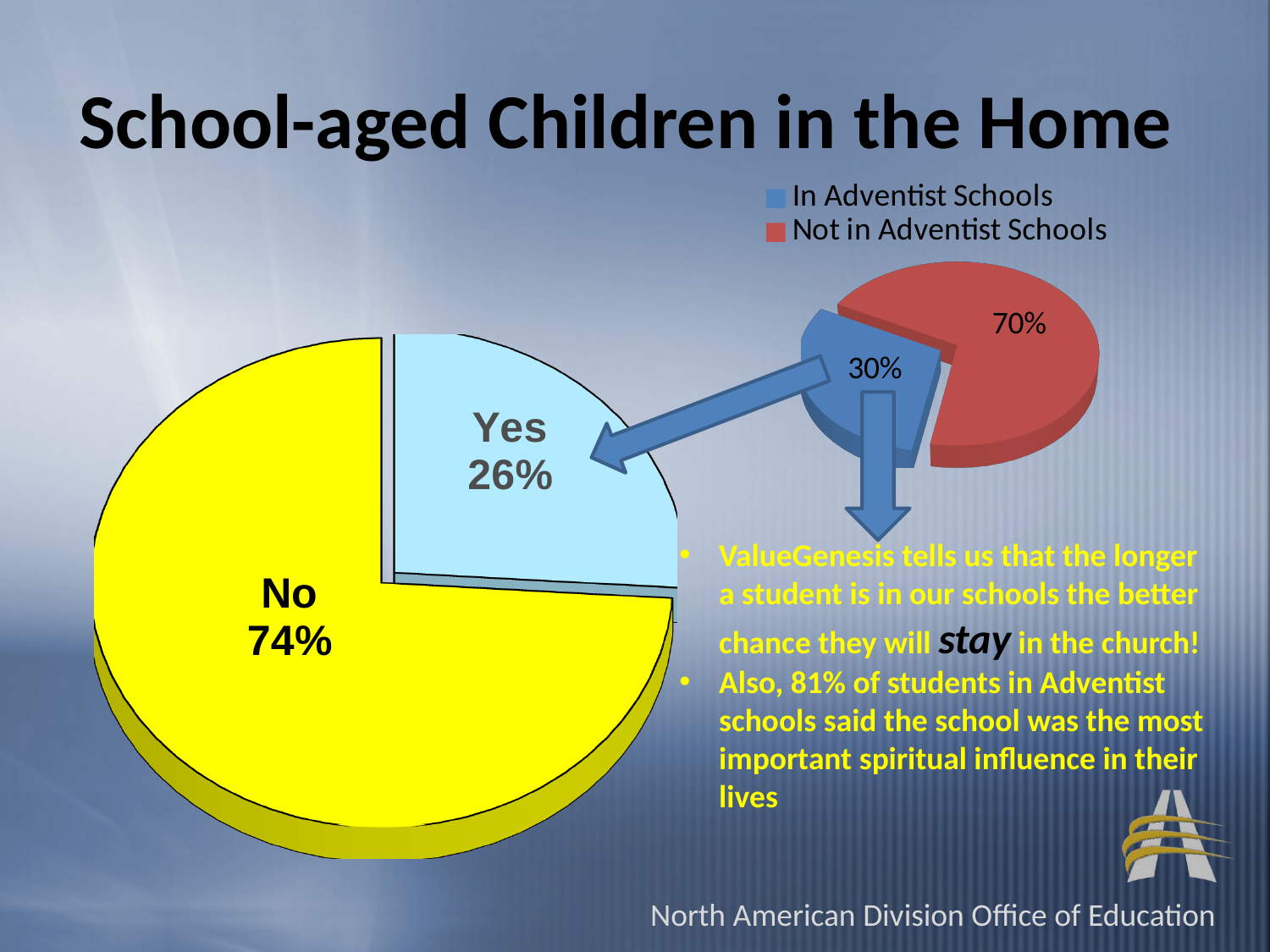
In the large pie chart on the left, what percentage is labelled "No"? 74% What type of chart is the large chart on the left of the slide? Pie chart How many slices does the large pie chart on the left have? 2 In the smaller pie chart on the upper right, which category has the largest share? Not in Adventist Schools In the large pie chart on the left, what percentage is labelled "Yes"? 26% In the large pie chart on the left, what is the difference in percentage points between the No slice and the Yes slice? 48 In the smaller pie chart on the upper right, what colour is the "Not in Adventist Schools" slice? Red In the smaller pie chart on the upper right, what percentage is shown for "Not in Adventist Schools"? 70% How many entries does the legend of the smaller pie chart on the upper right list? 2 In the smaller pie chart on the upper right, what is the difference in percentage points between "Not in Adventist Schools" and "In Adventist Schools"? 40 In the smaller pie chart on the upper right, what percentage is shown for "In Adventist Schools"? 30% In the large pie chart on the left, which slice is larger, Yes or No? No